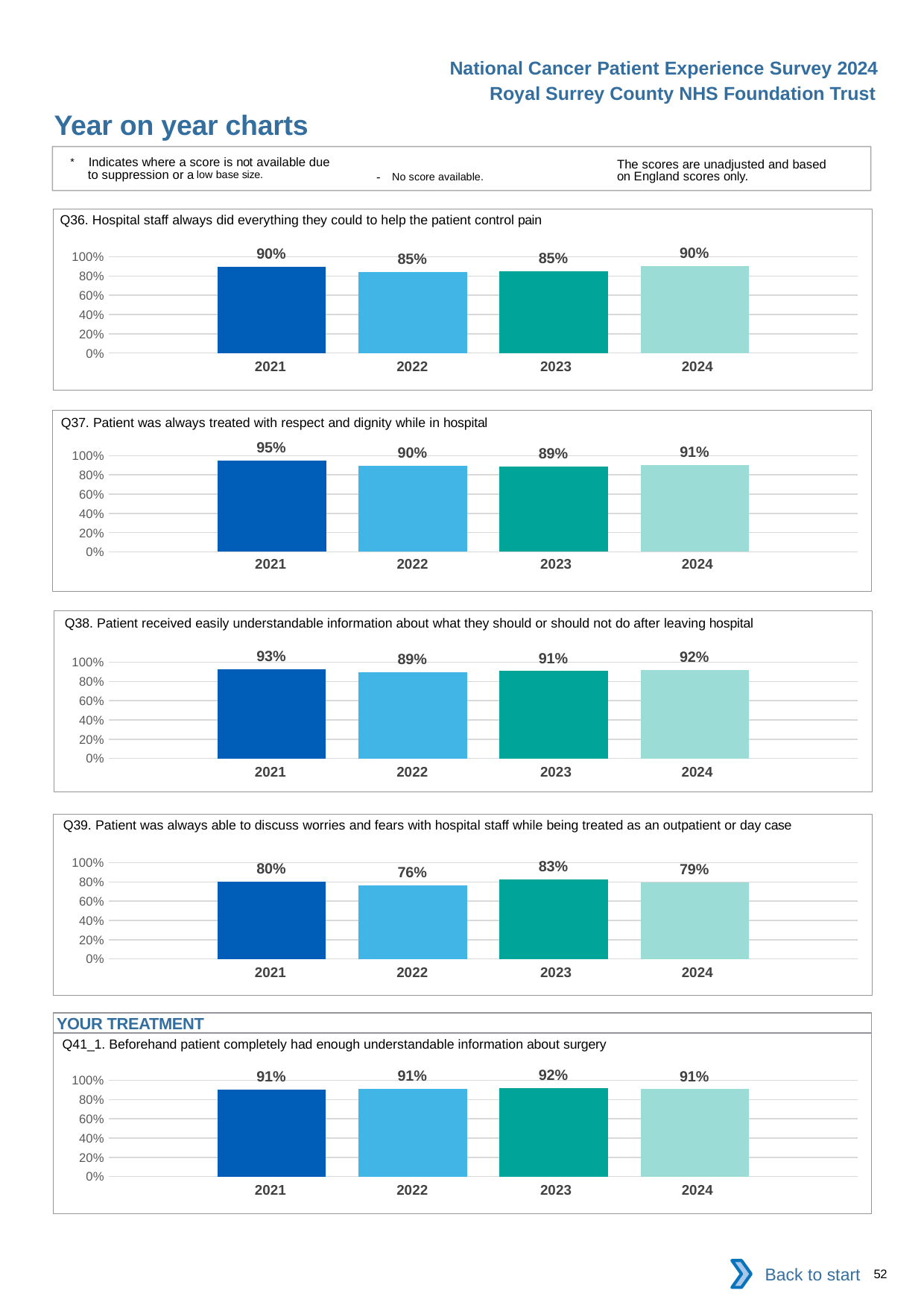
In the Q39 chart (Patient was always able to discuss worries and fears with hospital staff while being treated as an outpatient or day case), what is the difference between the 2023 and 2022 values? 7 percentage points In the Q41_1 chart (Beforehand patient completely had enough understandable information about surgery), what is the value for 2023? 92% In the Q36 chart (Hospital staff always did everything they could to help the patient control pain), is the value for 2021 greater or less than 80%? greater In the Q39 chart (Patient was always able to discuss worries and fears with hospital staff while being treated as an outpatient or day case), which year has the highest value? 2023 How many years (categories) are shown in the Q36 chart (Hospital staff always did everything they could to help the patient control pain)? 4 In the Q36 chart (Hospital staff always did everything they could to help the patient control pain), what is the value for 2022? 85% In the Q38 chart (Patient received easily understandable information about what they should or should not do after leaving hospital), which year has the lowest value? 2022 In the Q37 chart (Patient was always treated with respect and dignity while in hospital), what is the difference between the 2021 and 2023 values? 6 percentage points In the Q38 chart (Patient received easily understandable information about what they should or should not do after leaving hospital), what is the value for 2024? 92% What type of chart is the Q37 chart (Patient was always treated with respect and dignity while in hospital)? bar chart In the Q39 chart (Patient was always able to discuss worries and fears with hospital staff while being treated as an outpatient or day case), is the value for 2022 larger or smaller than the value for 2024? smaller In the Q37 chart (Patient was always treated with respect and dignity while in hospital), which year has the highest value? 2021